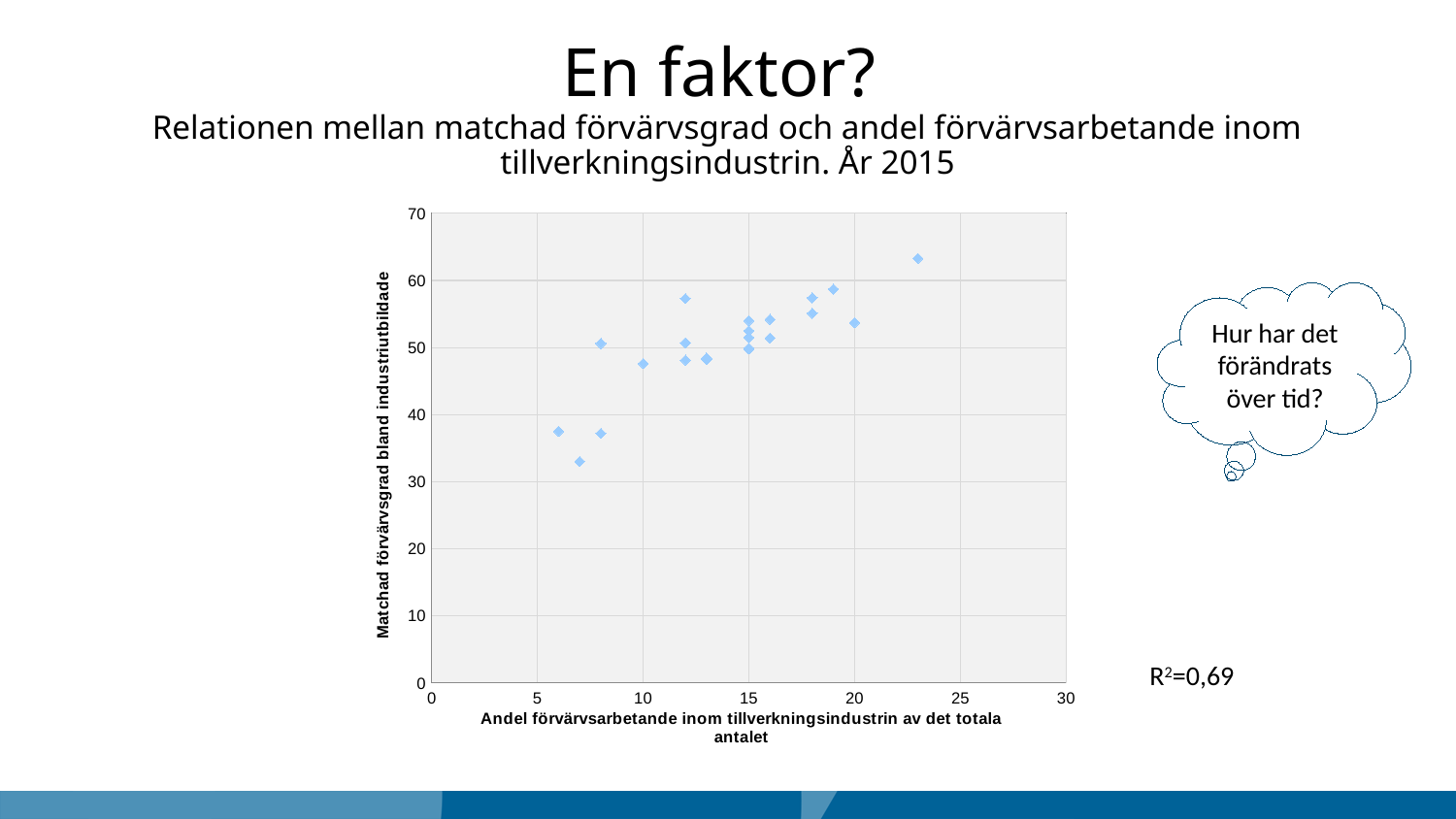
What is the highest tick value shown on the y axis? 70 Is the y value of the point with the highest x value greater or less than 60? greater What is the highest tick value shown on the x axis? 30 Do the plotted values generally rise or fall as the x-axis value increases? rise What kind of chart is shown on the slide? scatter plot Is the y value of the lowest point on the chart greater or less than 40? less What is the label of the x axis of the chart? Andel förvärvsarbetande inom tillverkningsindustrin av det totala antalet Is the x value of the leftmost point greater or less than 10? less